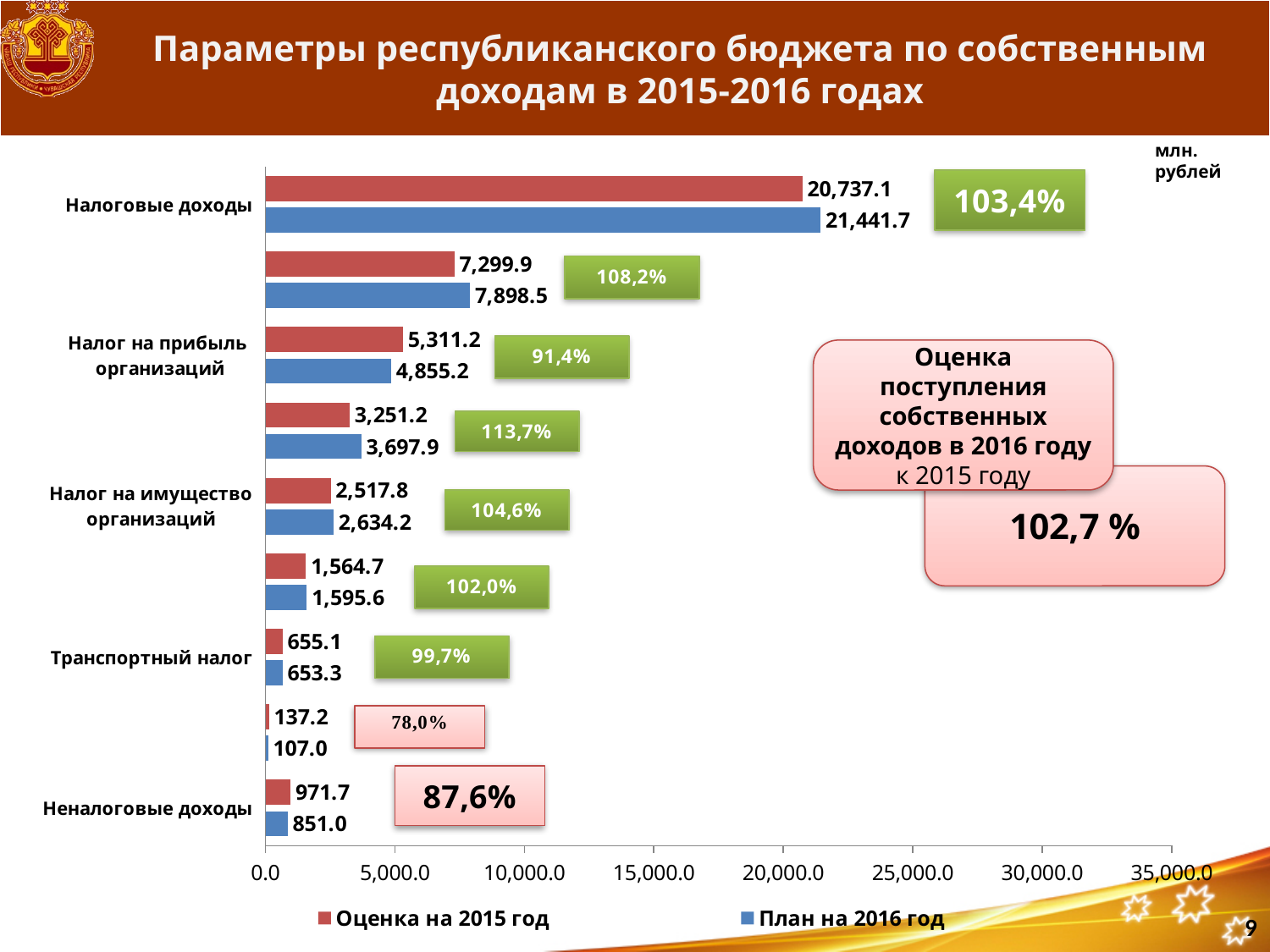
What is the value of План на 2016 год for Налог на прибыль организаций? 4,855.2 Which labelled category has the highest value for План на 2016 год? Налоговые доходы What is the value of Оценка на 2015 год for Налоговые доходы? 20,737.1 What is the value of План на 2016 год for Неналоговые доходы? 851.0 What is the value of Оценка на 2015 год for Налог на имущество организаций? 2,517.8 What is the value of Оценка на 2015 год for Транспортный налог? 655.1 Which series is shown in red in the chart legend? Оценка на 2015 год For Налог на прибыль организаций, which is larger: Оценка на 2015 год or План на 2016 год? Оценка на 2015 год By how much does План на 2016 год exceed Оценка на 2015 год for Налоговые доходы? 704.6 What kind of chart is shown on the slide? bar chart What is the value of План на 2016 год for Налоговые доходы? 21,441.7 How many series does the chart legend list? 2